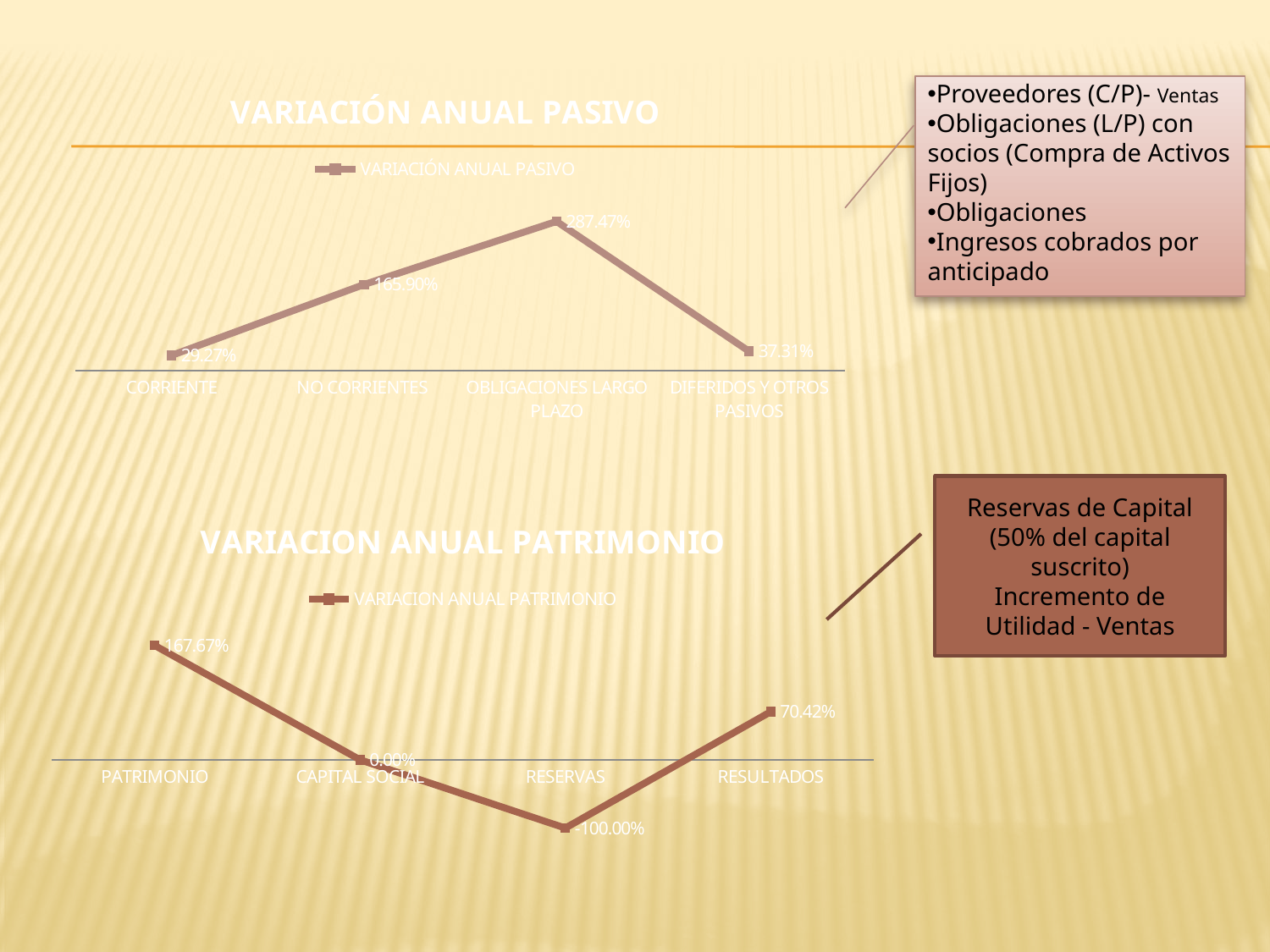
In the VARIACIÓN ANUAL PASIVO chart, what is the value for CORRIENTE? 29.27% In the VARIACION ANUAL PATRIMONIO chart, which category has the highest value? PATRIMONIO In the VARIACION ANUAL PATRIMONIO chart, which is larger, the value for PATRIMONIO or the value for RESULTADOS? PATRIMONIO In the VARIACION ANUAL PATRIMONIO chart, what is the value for RESULTADOS? 70.42% In the VARIACIÓN ANUAL PASIVO chart, what is the value for OBLIGACIONES LARGO PLAZO? 287.47% In the VARIACIÓN ANUAL PASIVO chart, which category has the lowest value? CORRIENTE In the VARIACIÓN ANUAL PASIVO chart, what is the difference between the values for OBLIGACIONES LARGO PLAZO and NO CORRIENTES? 121.57% In the VARIACION ANUAL PATRIMONIO chart, what is the value for RESERVAS? -100.00% In the VARIACION ANUAL PATRIMONIO chart, what is the difference between the values for PATRIMONIO and RESULTADOS? 97.25% In the VARIACIÓN ANUAL PASIVO chart, which category has the highest value? OBLIGACIONES LARGO PLAZO What kind of chart is the VARIACION ANUAL PATRIMONIO chart? Line chart In the VARIACIÓN ANUAL PASIVO chart, how many categories are plotted? 4